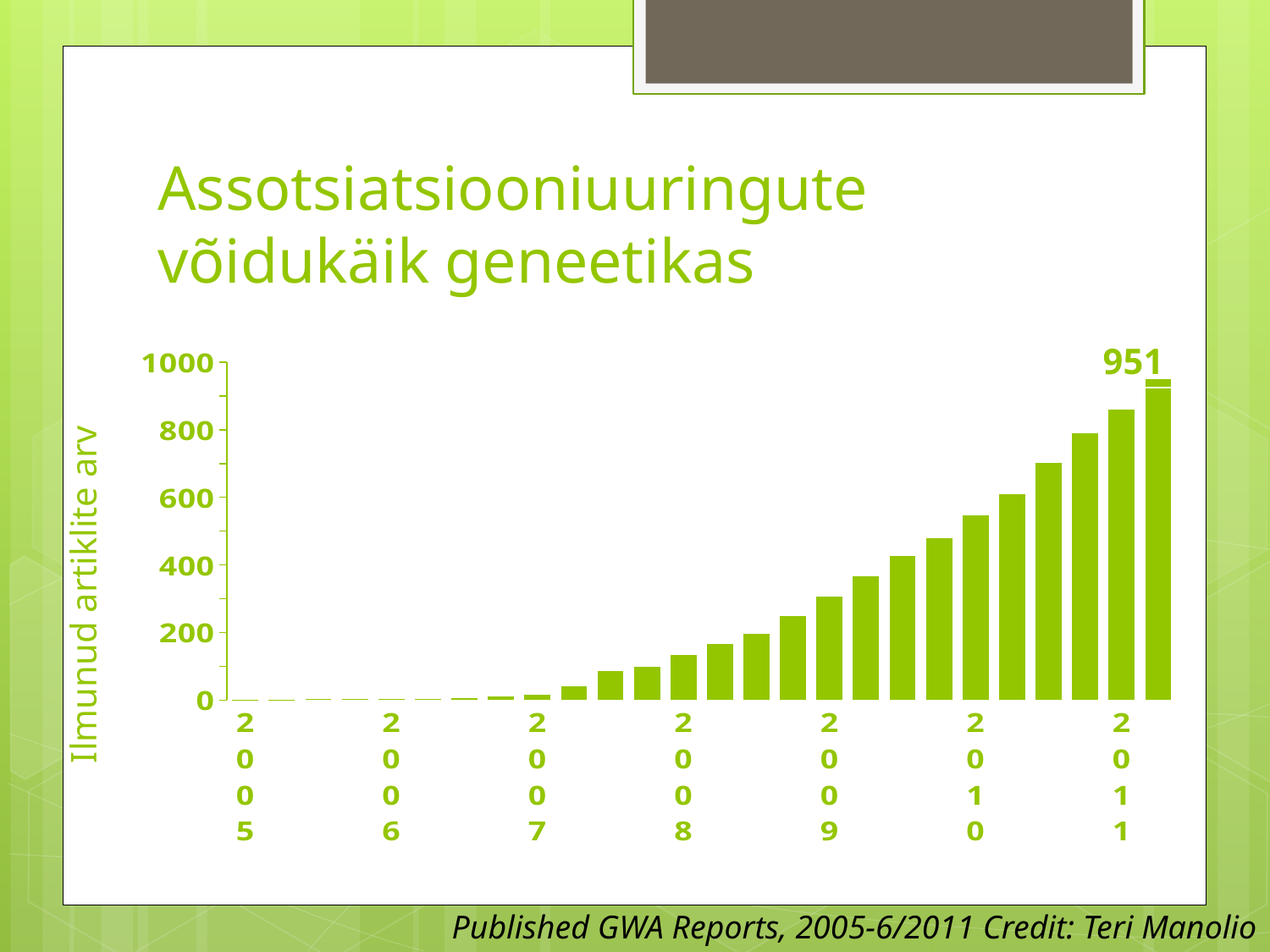
What value is printed as the data label on the tallest bar? 951 Is the value of the bar directly above the 2010 label greater or less than 400? greater Which year on the x axis has the lowest bars? 2005 Which year on the x axis has the tallest bar? 2011 What is the highest tick value shown on the vertical axis? 1000 Is the value of the bar directly above the 2008 label greater or less than 200? less Is the value of the bar directly above the 2009 label greater or less than 400? less Do the bar values rise or fall from 2005 to 2011 along the x axis? rise What kind of chart is shown on the slide? bar chart What is the label on the vertical axis of the chart? Ilmunud artiklite arv Which is larger: the bar above the 2010 label or the bar above the 2008 label? 2010